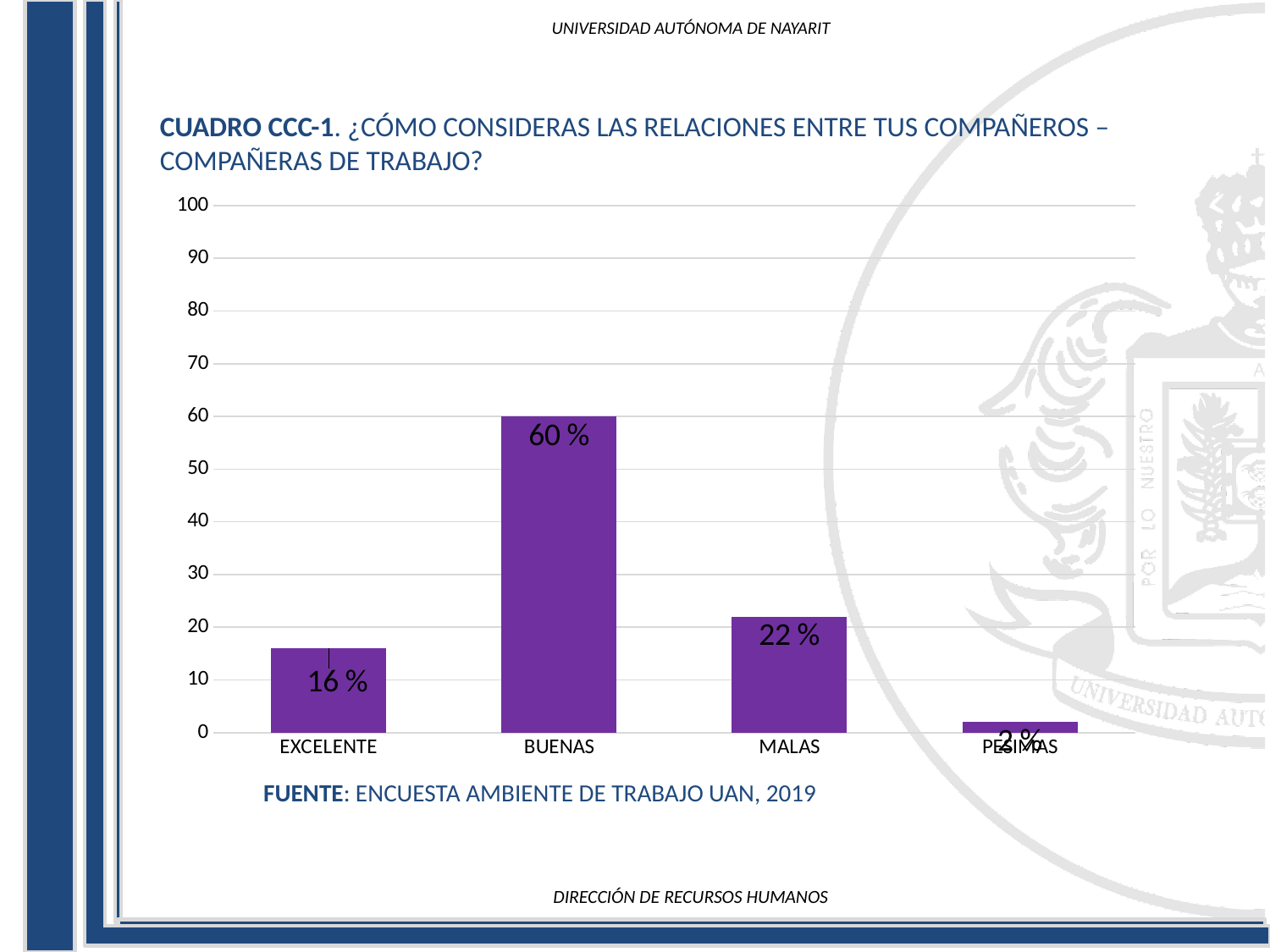
Is the value for BUENAS greater or less than 50? greater Which is larger, the value for MALAS or the value for EXCELENTE? MALAS What is the value for PÉSIMAS? 2 % Which category has the highest value? BUENAS Which category has the lowest value? PESIMAS What kind of chart is shown on the slide? bar chart What is the value for MALAS? 22 % What is the difference between the values for BUENAS and MALAS? 38 % What is the value for EXCELENTE? 16 % What source is cited below the chart? ENCUESTA AMBIENTE DE TRABAJO UAN, 2019 What is the value for BUENAS? 60 % How many categories are shown on the x axis? 4